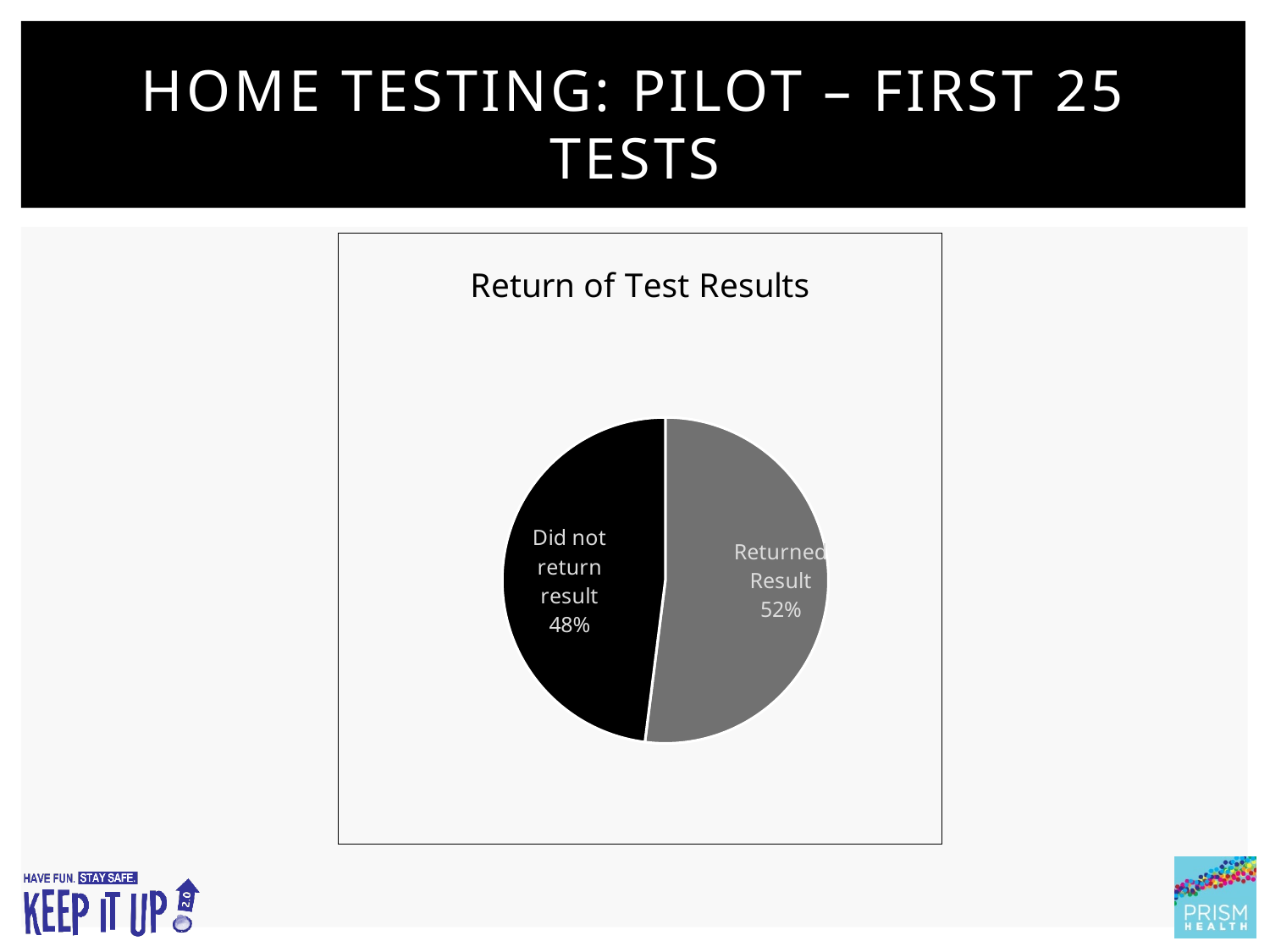
What is the difference in percentage points between the "Returned Result" and "Did not return result" slices? 4% Which slice of the pie is the largest? Returned Result Is the share for "Returned Result" greater or less than 50%? greater What kind of chart is shown on the slide? pie chart How many slices does the pie chart have? 2 Which slice of the pie is the smallest? Did not return result What colour is the "Did not return result" slice? black What is the title of the chart? Return of Test Results Which is larger: the "Returned Result" slice or the "Did not return result" slice? Returned Result What share of the pie is labelled "Returned Result"? 52% What share of the pie is labelled "Did not return result"? 48%